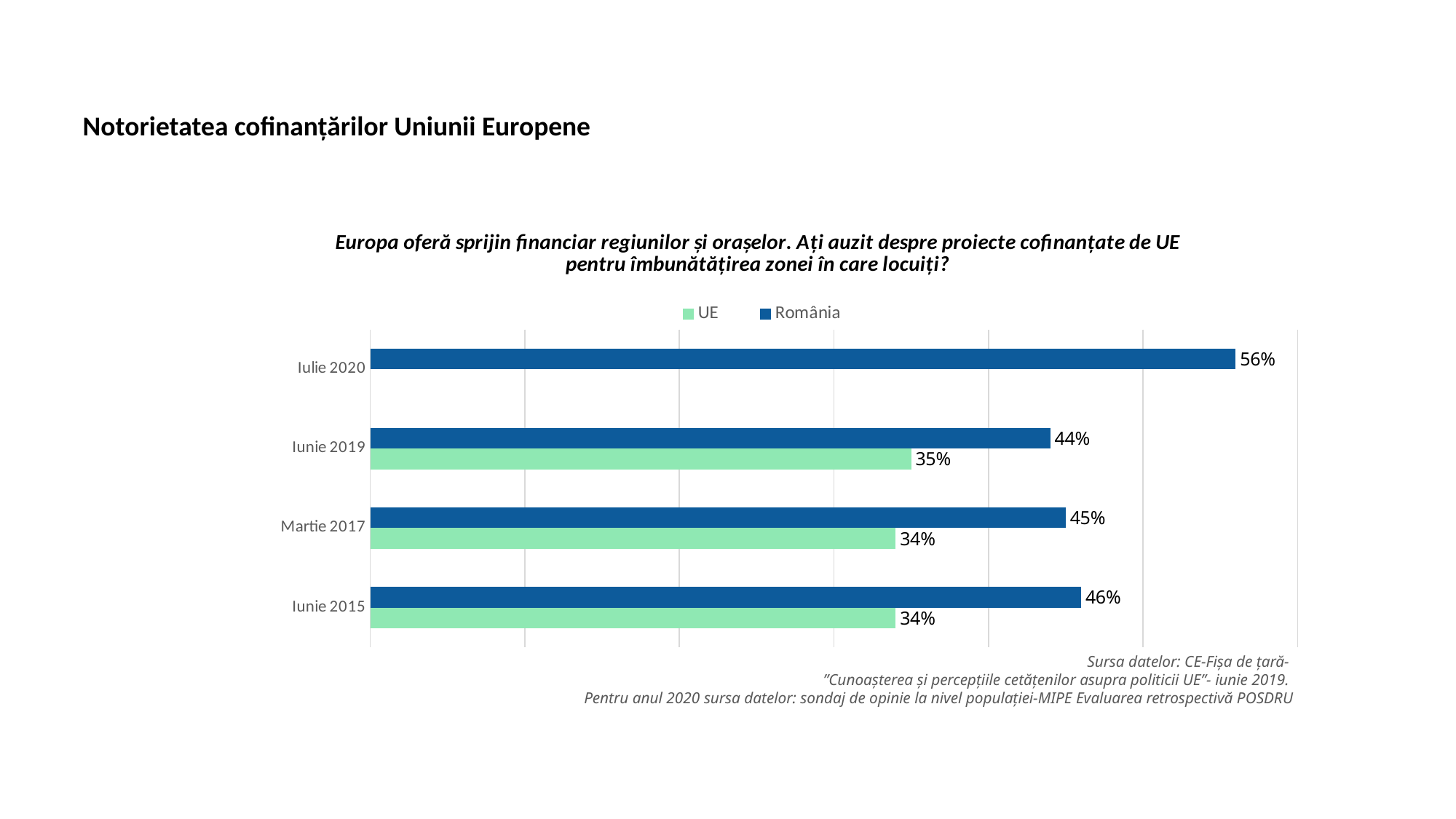
Which series is shown in green in the legend? UE What is the value for România in Iulie 2020? 56% In which period is the România value highest? Iulie 2020 What is the value for România in Martie 2017? 45% What is the value for UE in Iunie 2019? 35% What is the difference between the România and UE values in Iunie 2019? 9% How many series does the legend list? 2 Which is larger in Martie 2017, the România value or the UE value? România What is the value for UE in Iunie 2015? 34% How many time periods are shown on the chart? 4 What kind of chart is shown on the slide? Bar chart What is the difference between the România values for Iulie 2020 and Iunie 2015? 10%